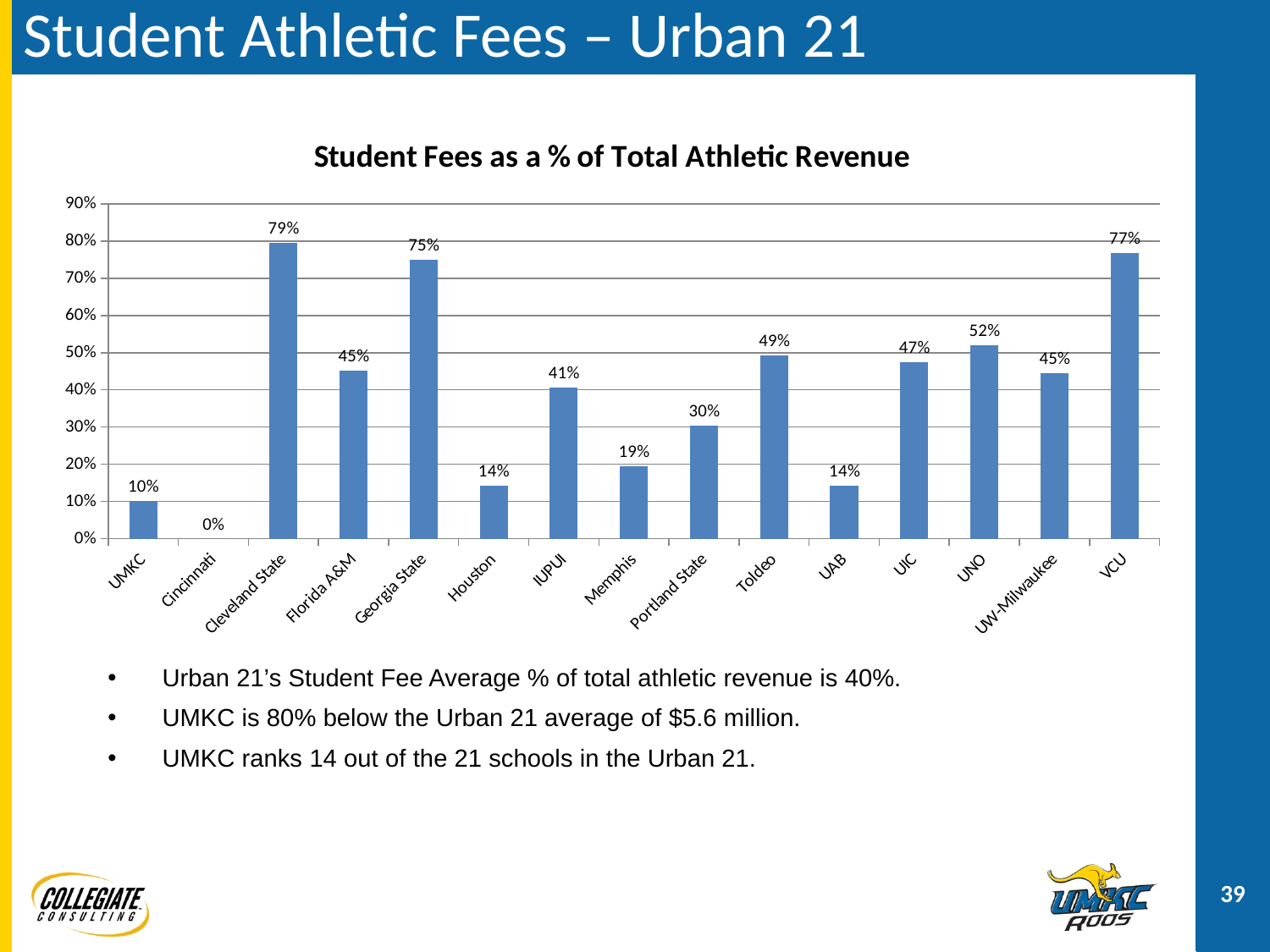
What is the difference between the values for UNO and UIC? 5 percentage points What percentage is shown for Georgia State? 75% What is the value for UMKC in the chart? 10% Which is larger, the value for VCU or the value for Cleveland State? Cleveland State Which school has the highest student fees as a % of total athletic revenue? Cleveland State What type of chart is shown on the slide? Bar chart Which school has the lowest value in the chart? Cincinnati What is the value for UNO? 52% What is the value shown for Memphis? 19% What is the difference between Cleveland State's value and UMKC's value? 69 percentage points Is the value for Portland State greater or less than 40%? less How many schools are shown on the x axis of the chart? 15